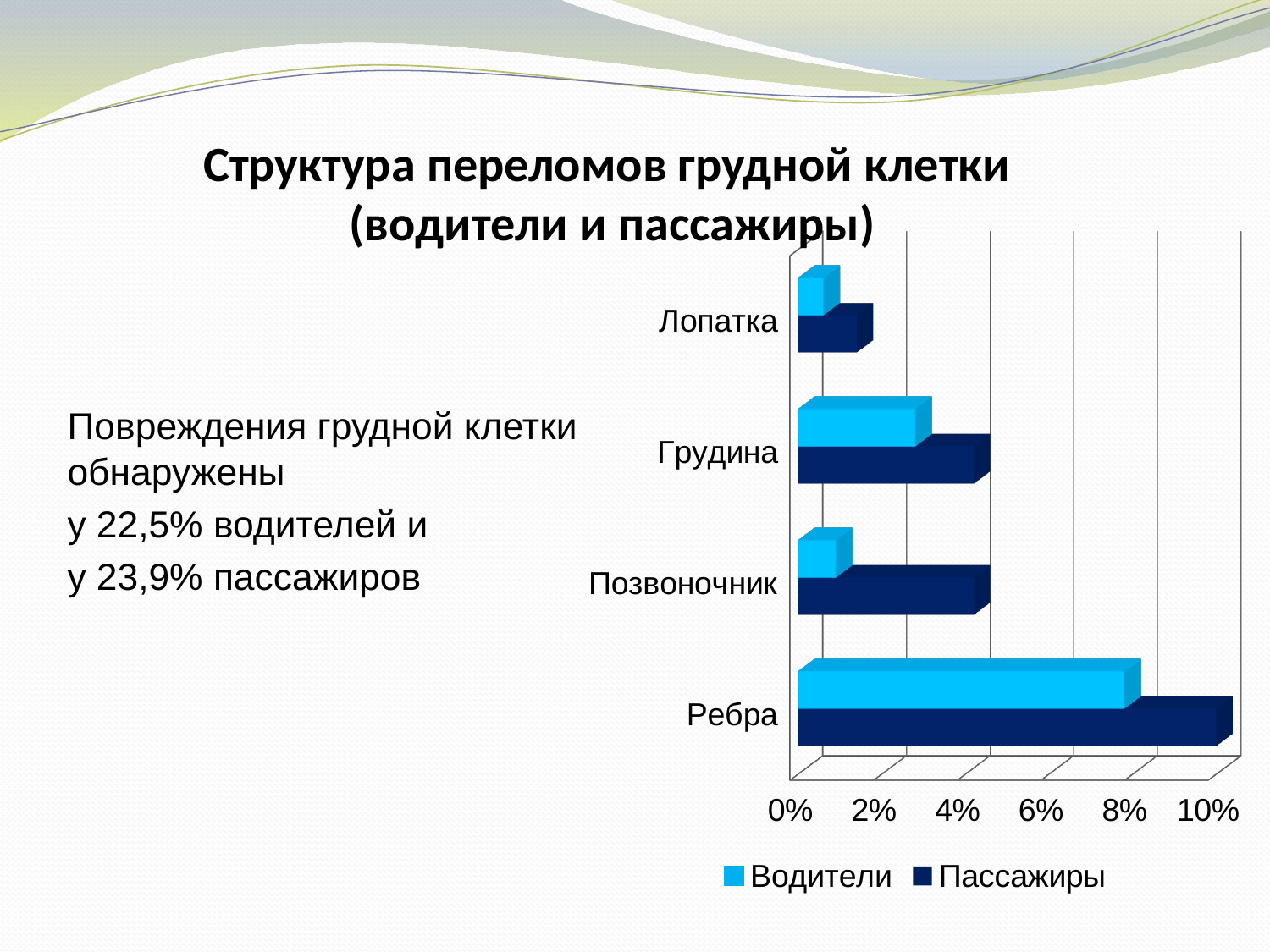
Is the value for Лопатка in the Водители series greater or less than 2%? less Which category has the lowest value for Пассажиры? Лопатка What are the two series named in the chart legend? Водители and Пассажиры Is the value for Ребра in the Пассажиры series greater or less than 8%? greater For Позвоночник, which series has the larger value, Водители or Пассажиры? Пассажиры What kind of chart is shown on the slide? bar chart How many series does the chart legend list? 2 Which is larger for Водители: the value for Ребра or the value for Грудина? Ребра Which category has the highest value for Водители? Ребра How many categories are plotted on the chart? 4 Is the value for Позвоночник in the Пассажиры series greater or less than 2%? greater